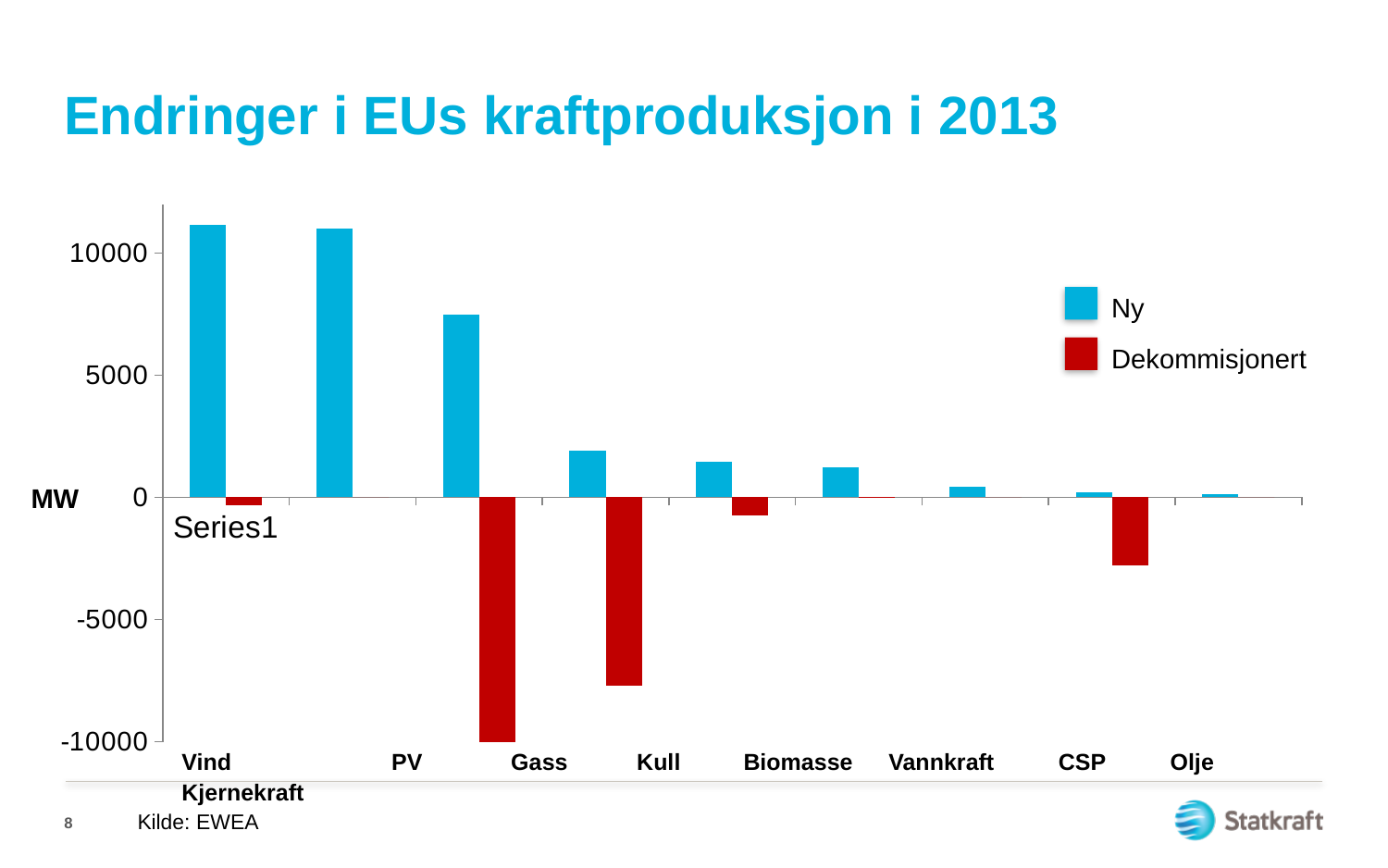
How many categories are shown on the x axis? 9 What is the title of the chart? Endringer i EUs kraftproduksjon i 2013 How many series does the legend list? 2 Do the Ny values generally rise or fall from left to right along the x axis? fall Is the Ny value for Olje greater or less than 5000? less Is the Dekommisjonert value for Vind greater or less than -5000? greater Which is larger, the Ny value for Vind or the Ny value for Olje? Vind What are the two series named in the legend? Ny and Dekommisjonert What kind of chart is shown on the slide? Bar chart Is the Ny value for Vind greater or less than 10000? greater